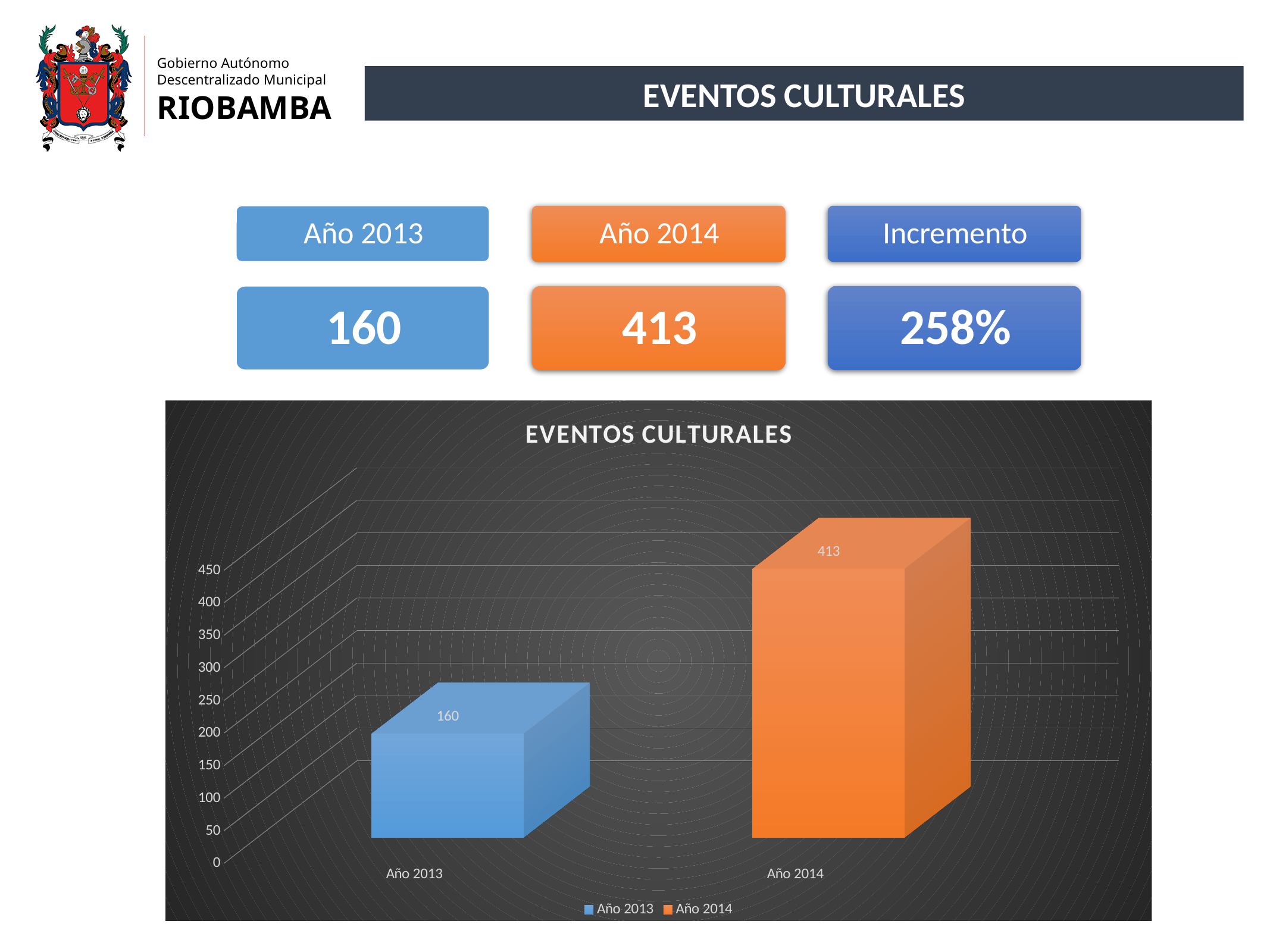
Which category has the lowest value in the chart? Año 2013 What kind of chart is shown on the slide? bar chart Which category has the highest value in the chart? Año 2014 What is the difference between the values for Año 2014 and Año 2013? 253 Is the value for Año 2014 greater or less than 400? greater How many entries does the chart legend list? 2 What is the value for Año 2013 in the chart? 160 Is the value for Año 2013 greater or less than 200? less Which is larger, the value for Año 2013 or the value for Año 2014? Año 2014 How many categories are shown on the x axis of the chart? 2 What is the title of the chart? EVENTOS CULTURALES What is the value for Año 2014 in the chart? 413